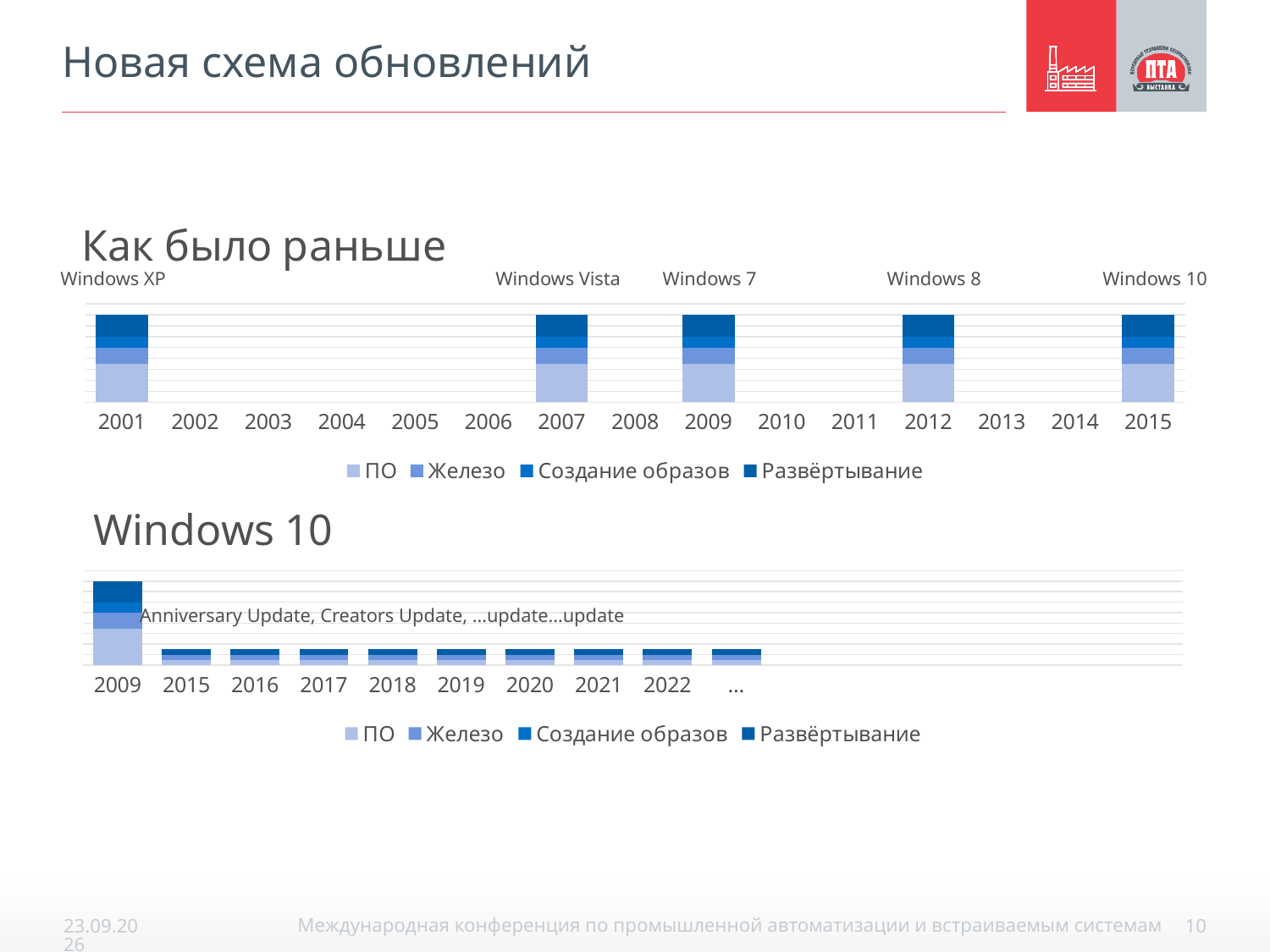
In the bottom chart "Windows 10", which category has the tallest bar? 2009 In the top chart "Как было раньше", what are the four legend entries? ПО, Железо, Создание образов, Развёртывание In the top chart "Как было раньше", how many year categories are shown on the x axis? 15 In the bottom chart "Windows 10", how many series does the legend list? 4 In the bottom chart "Windows 10", how many categories are shown on the x axis? 10 In the top chart "Как было раньше", how many series does the legend list? 4 What kind of chart is the top chart titled "Как было раньше"? bar chart In the bottom chart "Windows 10", do the bars from 2015 to 2022 rise, fall, or stay about the same? stay about the same What kind of chart is the bottom chart titled "Windows 10"? bar chart In the bottom chart "Windows 10", which bar is taller, 2009 or 2015? 2009 In the top chart "Как было раньше", how many years have a bar plotted? 5 In the top chart "Как было раньше", which Windows version label appears above the 2007 bar? Windows Vista